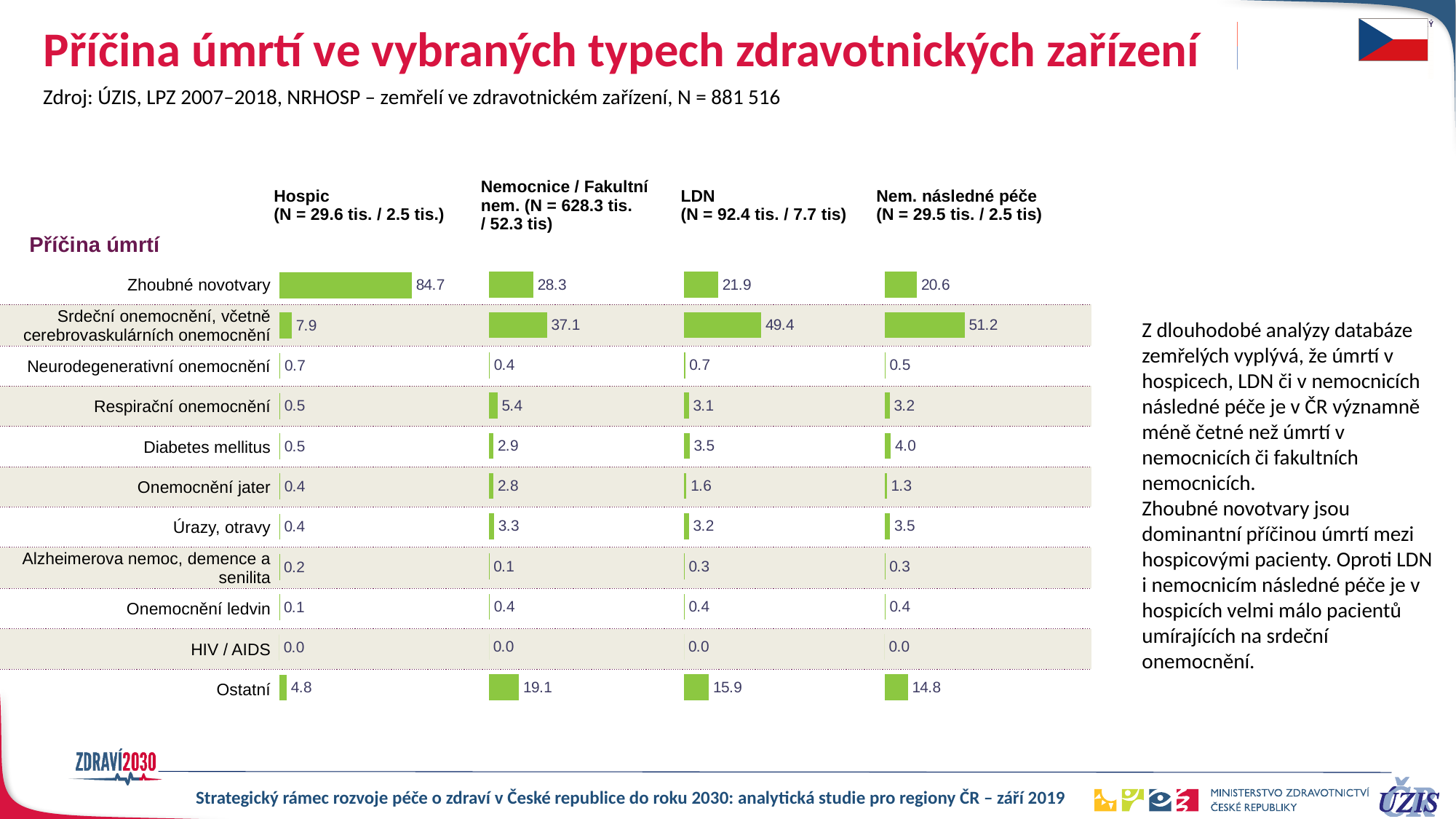
What is the difference between the Nem. následné péče and Hospic values for Srdeční onemocnění, včetně cerebrovaskulárních onemocnění? 43.3 What is the value for Srdeční onemocnění, včetně cerebrovaskulárních onemocnění in the LDN column? 49.4 What is the difference between the Hospic and Nemocnice / Fakultní nem. values for Zhoubné novotvary? 56.4 For Srdeční onemocnění, včetně cerebrovaskulárních onemocnění, which column has the larger value: LDN or Nem. následné péče? Nem. následné péče What is the value for Ostatní in the Nem. následné péče column? 14.8 What kind of chart is used on this slide? Bar chart How many types of healthcare facility (columns) does the chart compare? 4 Which cause of death has the highest value in the Hospic column? Zhoubné novotvary Which cause of death has the highest value in the Nem. následné péče column? Srdeční onemocnění, včetně cerebrovaskulárních onemocnění How many causes of death (rows) are shown in the chart? 11 What is the value for Zhoubné novotvary in the Hospic column? 84.7 What is the value for Respirační onemocnění in the Nemocnice / Fakultní nem. column? 5.4